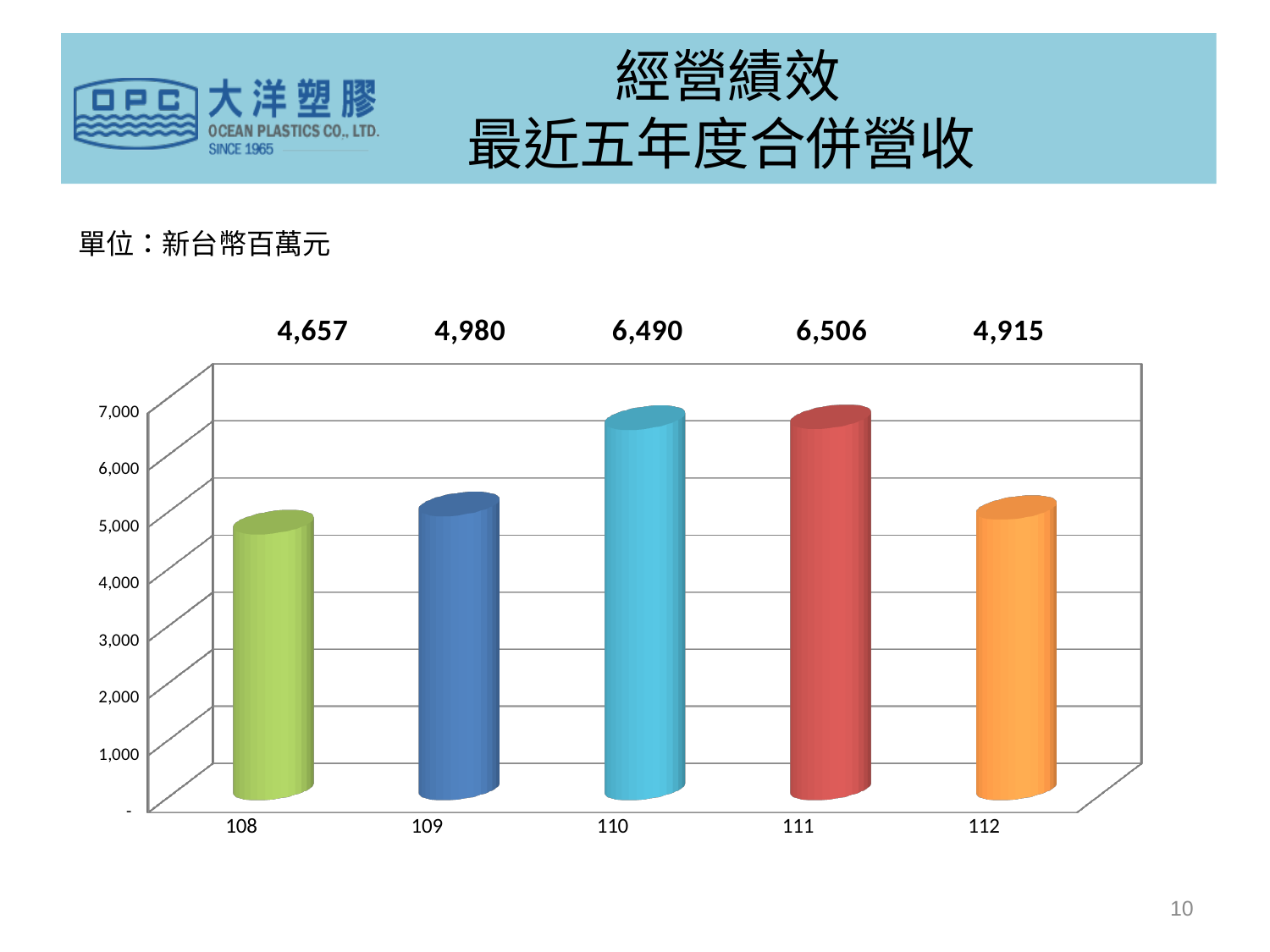
What is the value shown for year 112? 4,915 What is the value shown for year 110? 6,490 What kind of chart is shown on the slide? bar chart Which is larger, the value for year 109 or the value for year 112? 109 What unit is stated for the values on the slide? 新台幣百萬元 Which year has the highest value? 111 What is the difference between the values for year 111 and year 108? 1,849 Which year has the lowest value? 108 What is the consolidated revenue value shown for year 108? 4,657 What is the difference between the values for year 110 and year 109? 1,510 How many years are shown on the x axis? 5 Is the value for year 112 greater or less than 5,000? less